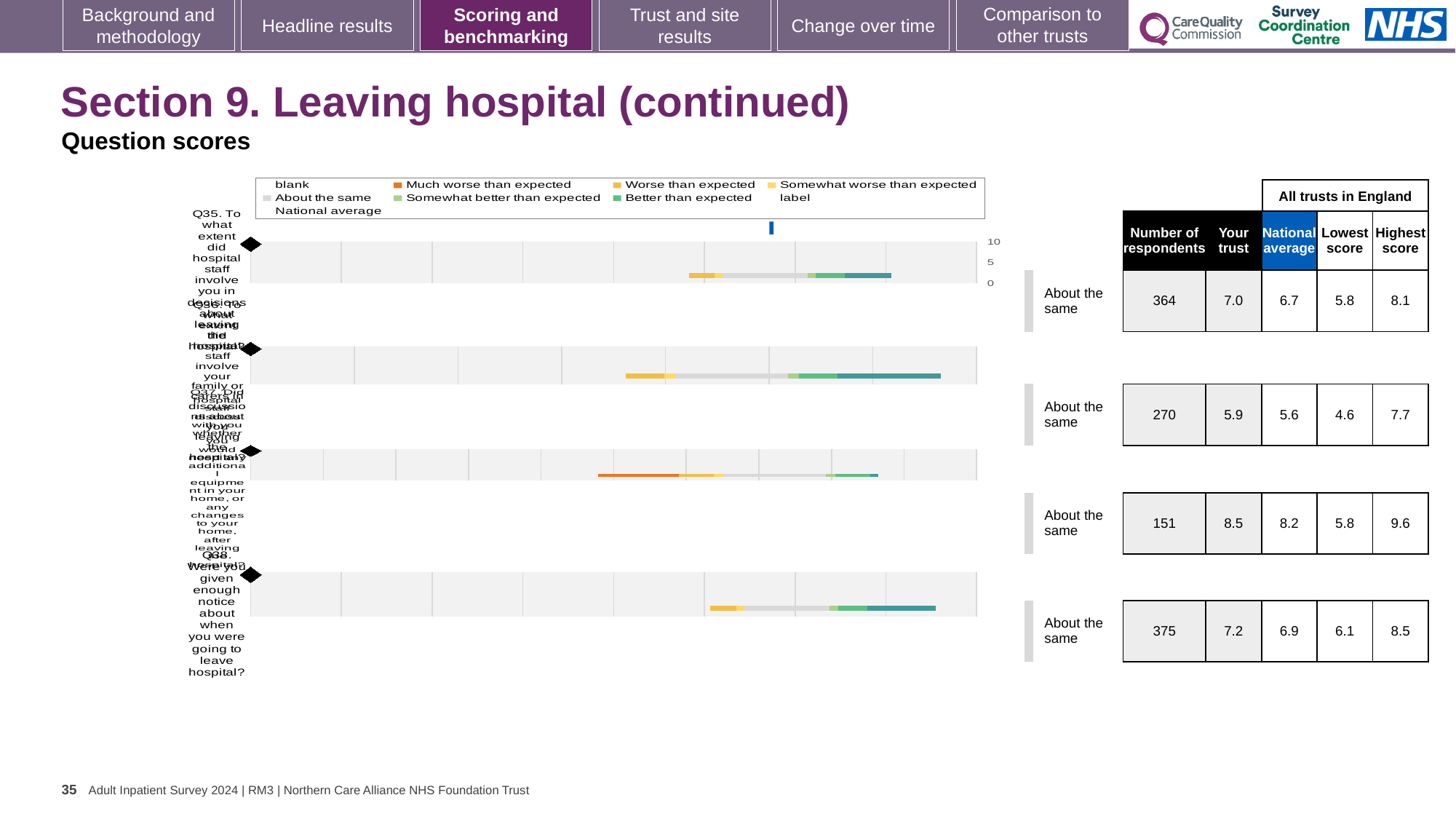
Which legend entry is shown in dark orange? Much worse than expected In the table beside the chart, what is the difference between the 'Your trust' score and the national average for Q38 (the last bar)? 0.3 What kind of chart is shown on the slide? Bar chart How many question bars are plotted in the chart? 4 In the table beside the chart, which row has the highest 'Your trust' score? The third row (8.5) In the table beside the chart, what is the 'Your trust' score for Q35 (the first bar)? 7.0 In the table beside the chart, which row has the lowest number of respondents? The third row (151) What is the subtitle shown above the chart? Question scores What benchmark label is shown next to each of the four bars? About the same In the table beside the chart, what is the national average for Q38 (the last bar)? 6.9 In the table beside the chart, what is the number of respondents for Q38 (the last bar)? 375 In the table beside the chart, is the 'Your trust' score higher for Q35 (first bar) or Q38 (last bar)? Q38